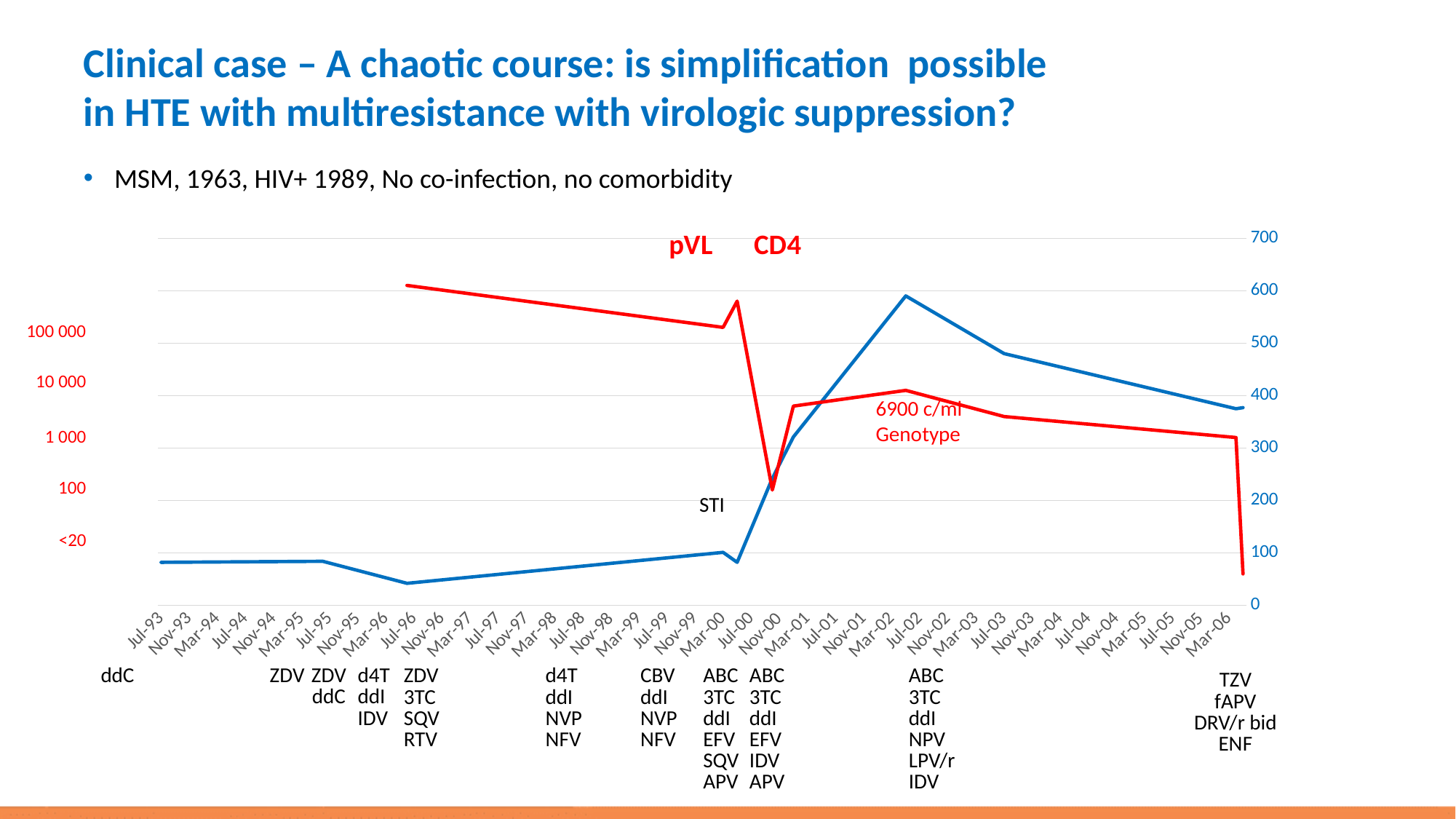
How many series does the chart plot? 2 Is the CD4 value at Jul-02 greater or less than 500? greater Which is larger, the CD4 value at Jul-02 or at Mar-06? Jul-02 Does the CD4 line rise or fall between Jul-02 and Mar-06? fall What kind of chart is shown on the slide? line chart What viral load value is printed as a label on the chart? 6900 c/ml Is the pVL value at Jul-96 greater or less than 100 000? greater Which series is drawn in red? pVL Is the CD4 value at Jul-96 greater or less than 100? less